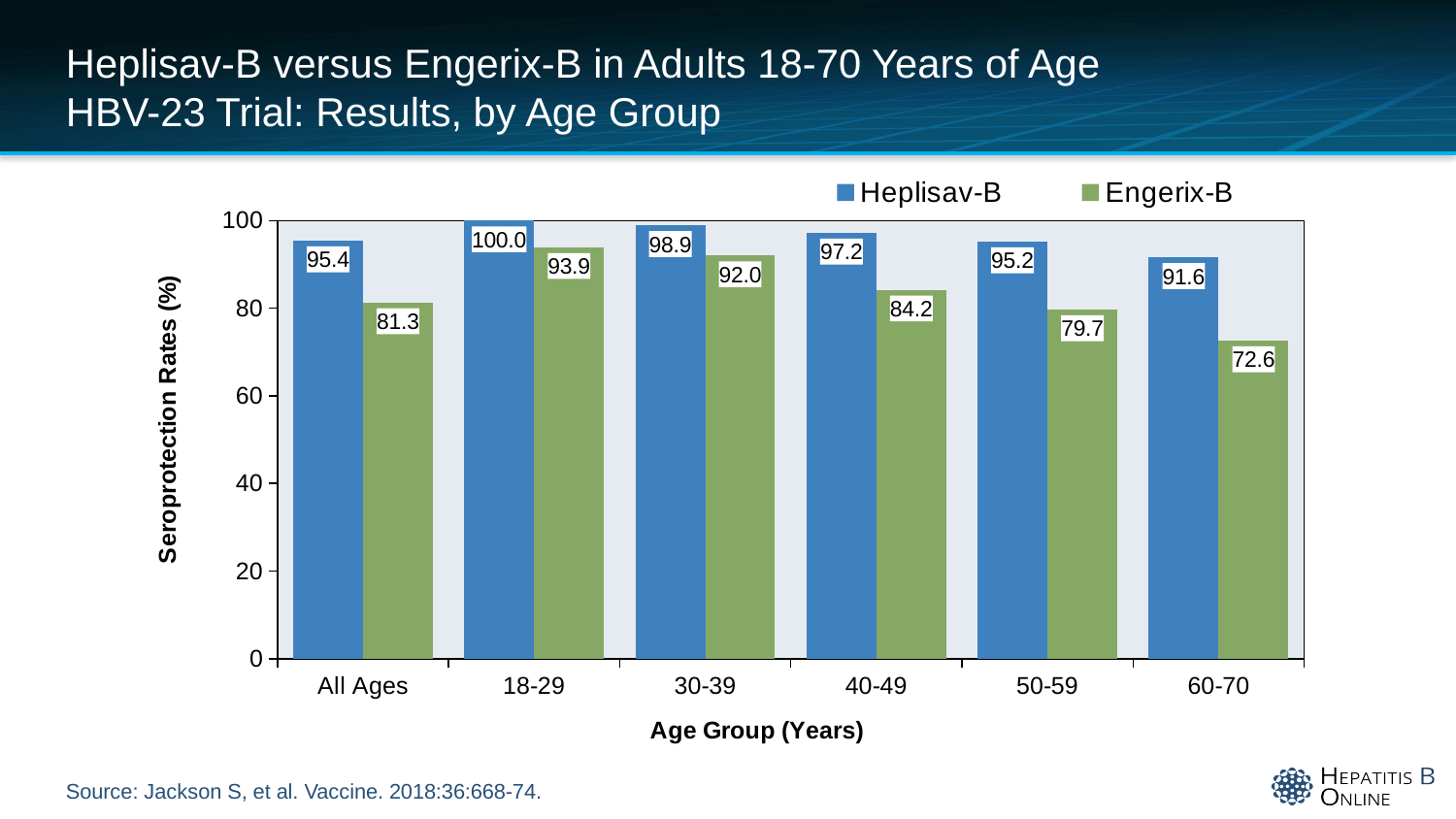
Which age group has the highest Heplisav-B seroprotection rate? 18-29 What is the Heplisav-B seroprotection rate for the 40-49 age group? 97.2 Is the Engerix-B seroprotection rate for the 60-70 age group greater or less than 80? less What is the Engerix-B seroprotection rate for the 60-70 age group? 72.6 What is the difference between the Heplisav-B and Engerix-B seroprotection rates in the 50-59 age group? 15.5 Which is larger, the Engerix-B rate for 30-39 or the Engerix-B rate for 40-49? 30-39 Do the Engerix-B seroprotection rates rise or fall from the 18-29 group to the 60-70 group? fall What is the Engerix-B seroprotection rate for All Ages? 81.3 How many age group categories are shown on the x axis? 6 How many series does the legend list? 2 Which age group has the lowest Engerix-B seroprotection rate? 60-70 What kind of chart is shown on the slide? bar chart